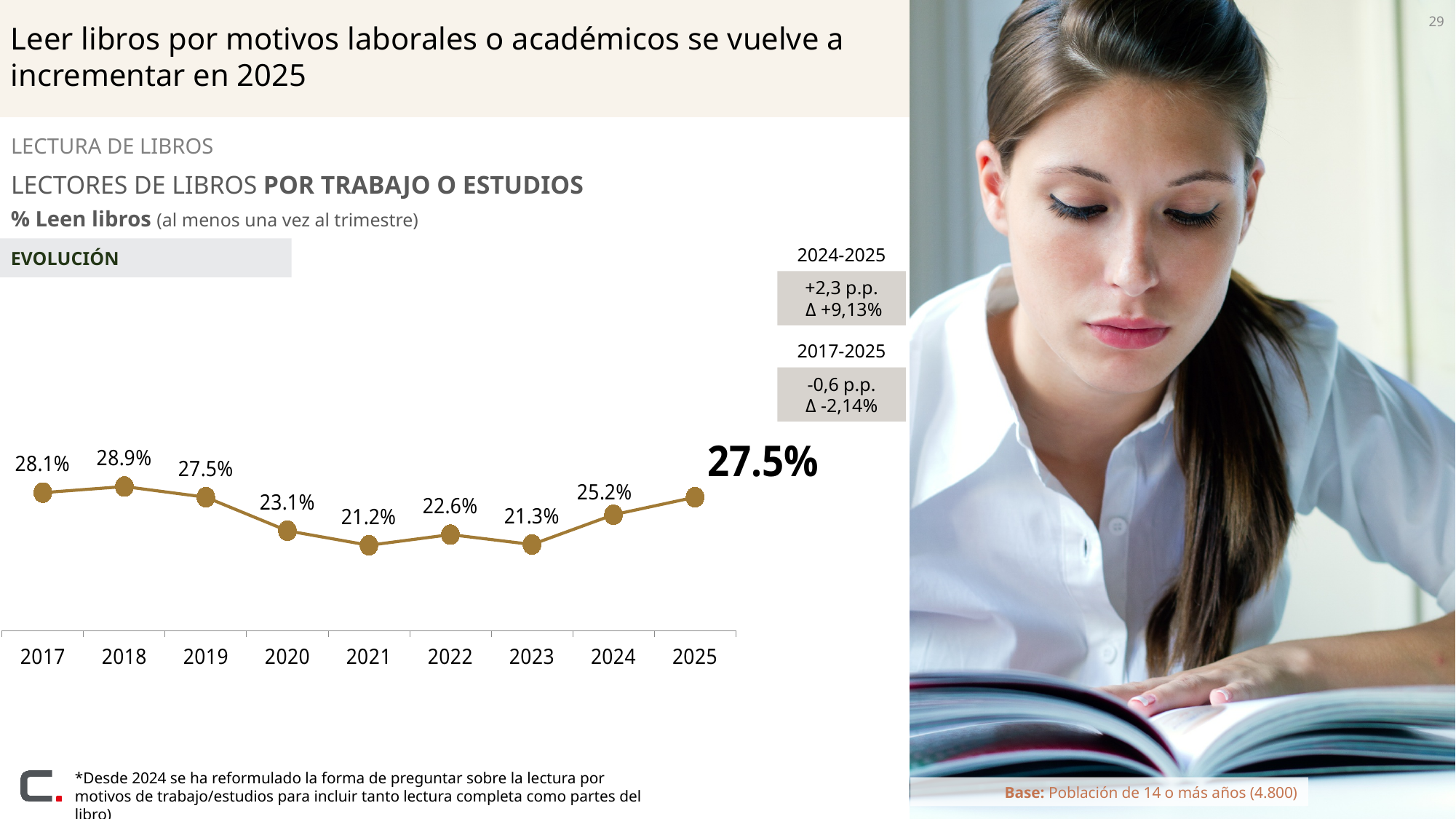
Which year has the lowest value? 2021 What type of chart is shown on the slide? line chart What is the value for 2017? 28.1% Do the values rise or fall from 2023 to 2025? rise Which year has the highest value? 2018 What is the value for 2020? 23.1% What is the value for 2025? 27.5% Do the values rise or fall from 2018 to 2021? fall Which is larger, the value for 2020 or the value for 2024? 2024 What is the difference between the values for 2018 and 2017? 0.8 percentage points How many years are plotted on the chart? 9 What is the difference between the values for 2025 and 2024? 2.3 percentage points